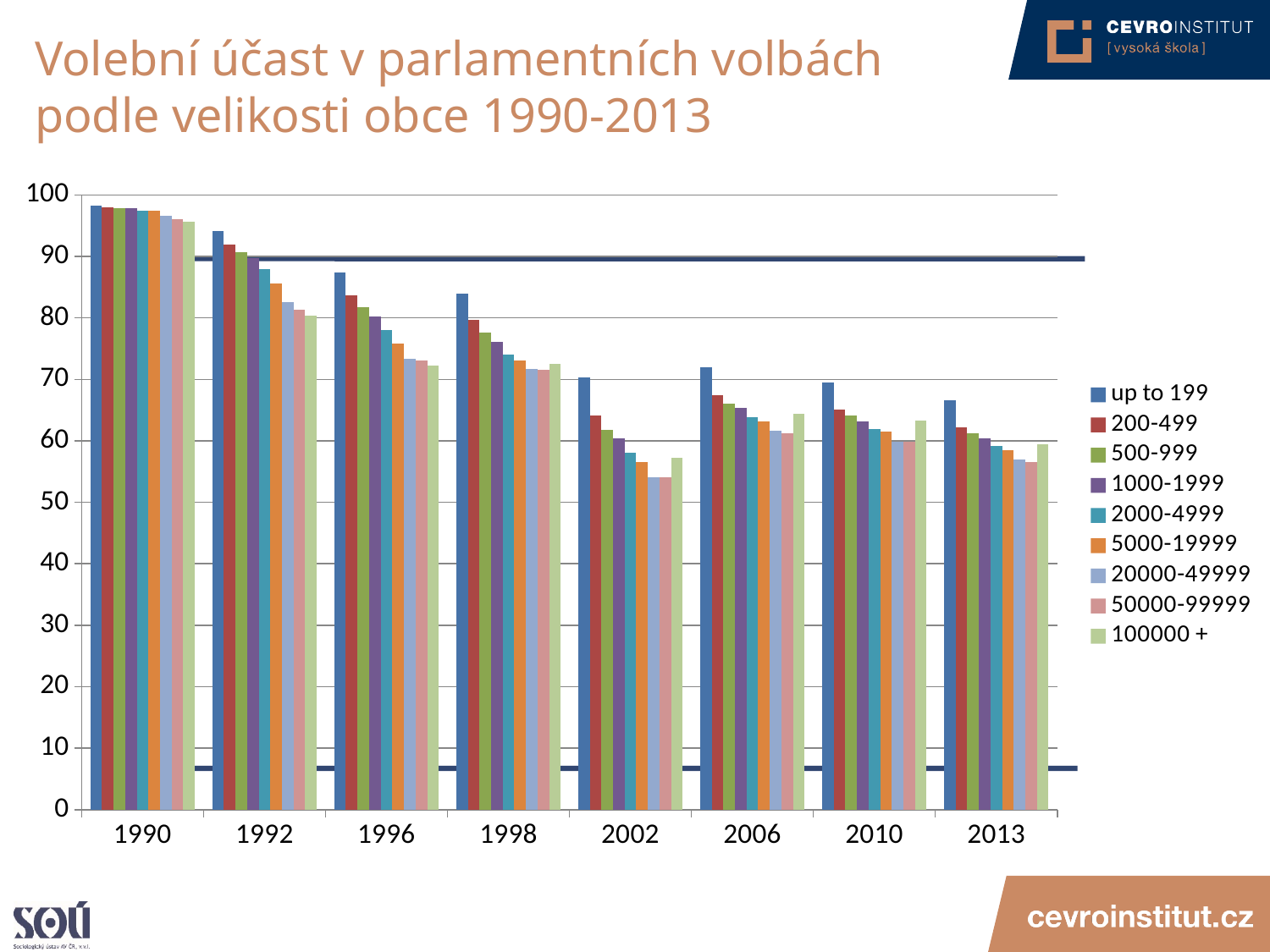
Which is larger: the 'up to 199' value in 1990 or in 2013? 1990 How many years (categories) are shown on the x axis? 8 Is the value for 'up to 199' in 2013 greater or less than 60? greater Is the value for '20000-49999' in 2002 greater or less than 60? less What kind of chart is shown on the slide? bar chart In 2002, which is larger: the value for 'up to 199' or for '100000 +'? up to 199 Do the values for 'up to 199' generally rise or fall from 1990 to 2013? fall In which year is the value for 'up to 199' highest? 1990 Is the value for 'up to 199' in 1996 greater or less than 90? less How many series does the legend list? 9